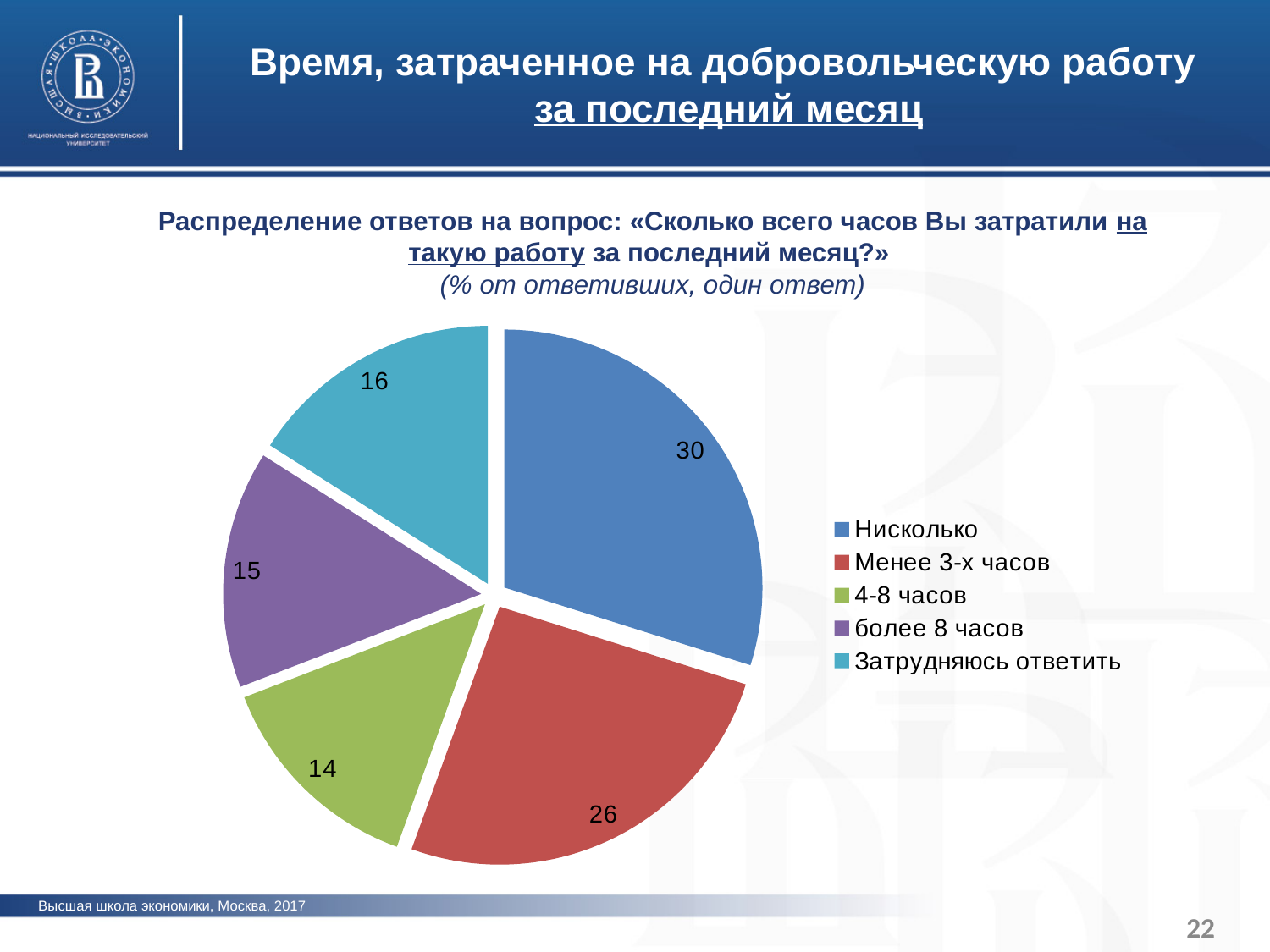
Which is larger: the value for "Затрудняюсь ответить" or the value for "более 8 часов"? Затрудняюсь ответить What is the value for the "4-8 часов" slice? 14 How many categories does the pie chart have? 5 What is the value for the "Менее 3-х часов" slice? 26 Which category has the smallest slice of the pie? 4-8 часов Which category has the largest slice of the pie? Нисколько What is the value for the "Нисколько" slice? 30 What colour is the "Менее 3-х часов" slice? red What is the value for the "Затрудняюсь ответить" slice? 16 What type of chart is shown on the slide? pie chart What is the value for the "более 8 часов" slice? 15 What is the difference between the values for "Нисколько" and "Менее 3-х часов"? 4